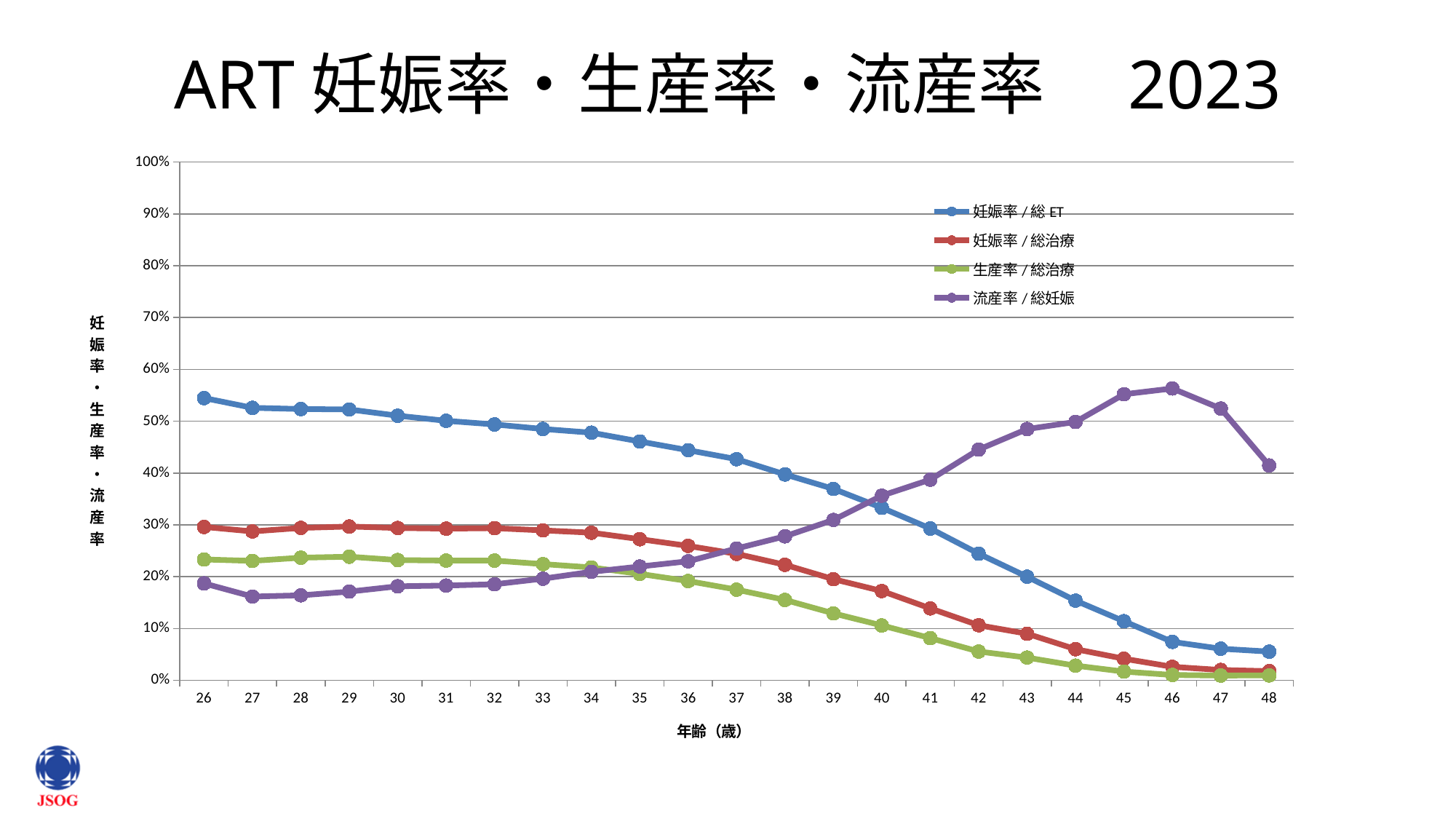
At which age is 妊娠率 / 総 ET lowest? 48 Is the value for 流産率 / 総妊娠 at age 46 greater or less than 50%? greater Is the value for 妊娠率 / 総治療 at age 26 greater or less than 20%? greater At which age is 妊娠率 / 総 ET highest? 26 What is the label of the x axis? 年齢（歳） How many age categories are plotted along the x axis? 23 Is the value for 生産率 / 総治療 at age 40 greater or less than 20%? less What kind of chart is shown on the slide? line chart Does 妊娠率 / 総 ET rise or fall as age increases from 26 to 48? fall At age 41, which is larger: 妊娠率 / 総 ET or 流産率 / 総妊娠? 流産率 / 総妊娠 How many series does the legend list? 4